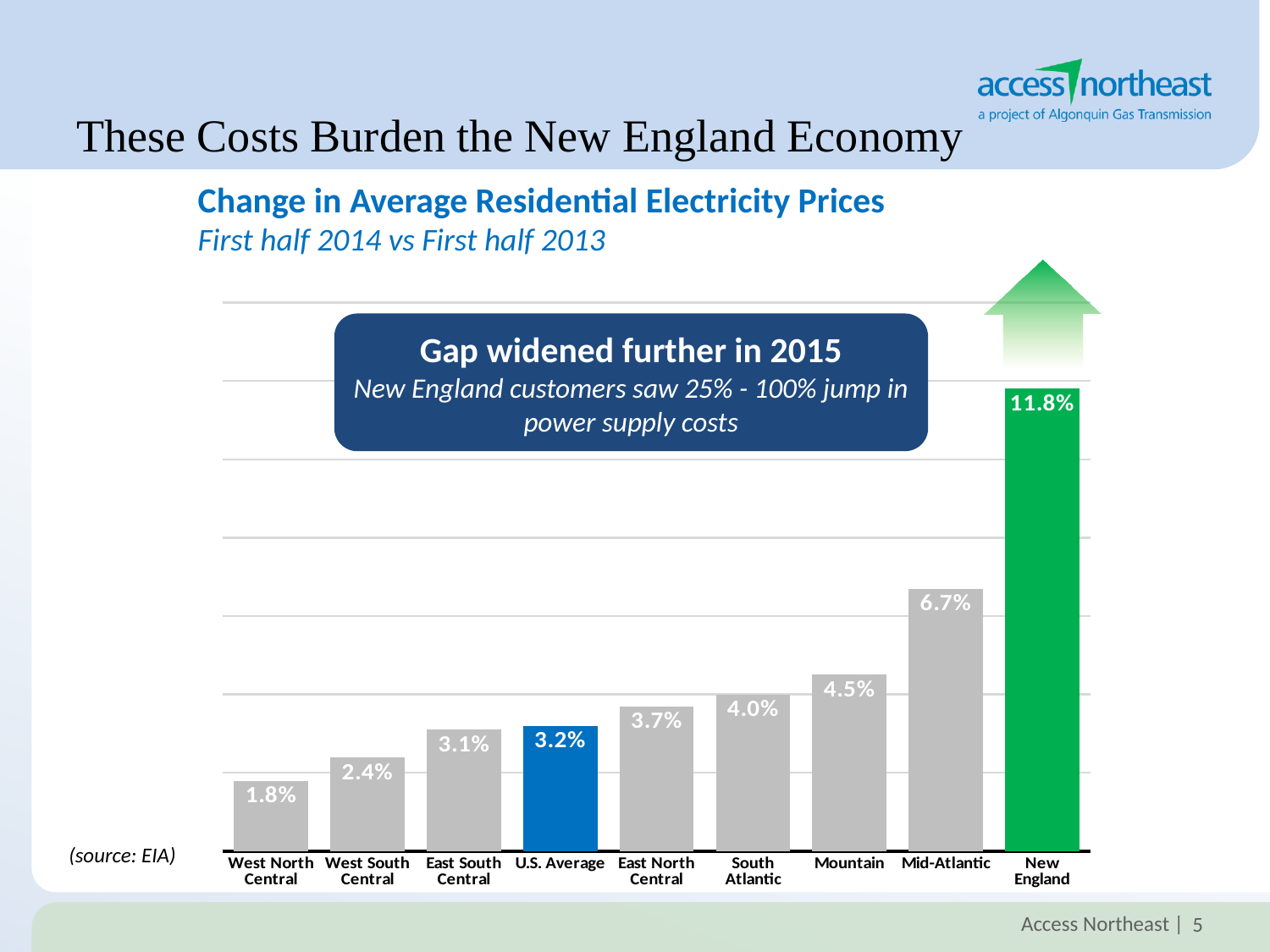
What is the value shown for West North Central? 1.8% Which is larger, the value for South Atlantic or the value for East North Central? South Atlantic What is the value shown for Mid-Atlantic? 6.7% What is the change in average residential electricity prices for New England? 11.8% Do the values rise or fall moving from left to right along the x axis? Rise What kind of chart is shown on the slide? Bar chart What is the difference between the Mid-Atlantic value and the Mountain value? 2.2% Which region has the lowest change in average residential electricity prices? West North Central What is the value shown for the U.S. Average? 3.2% How many regions (bars) are shown in the chart? 9 What is the difference between the New England value and the U.S. Average value? 8.6% Which region has the highest change in average residential electricity prices? New England